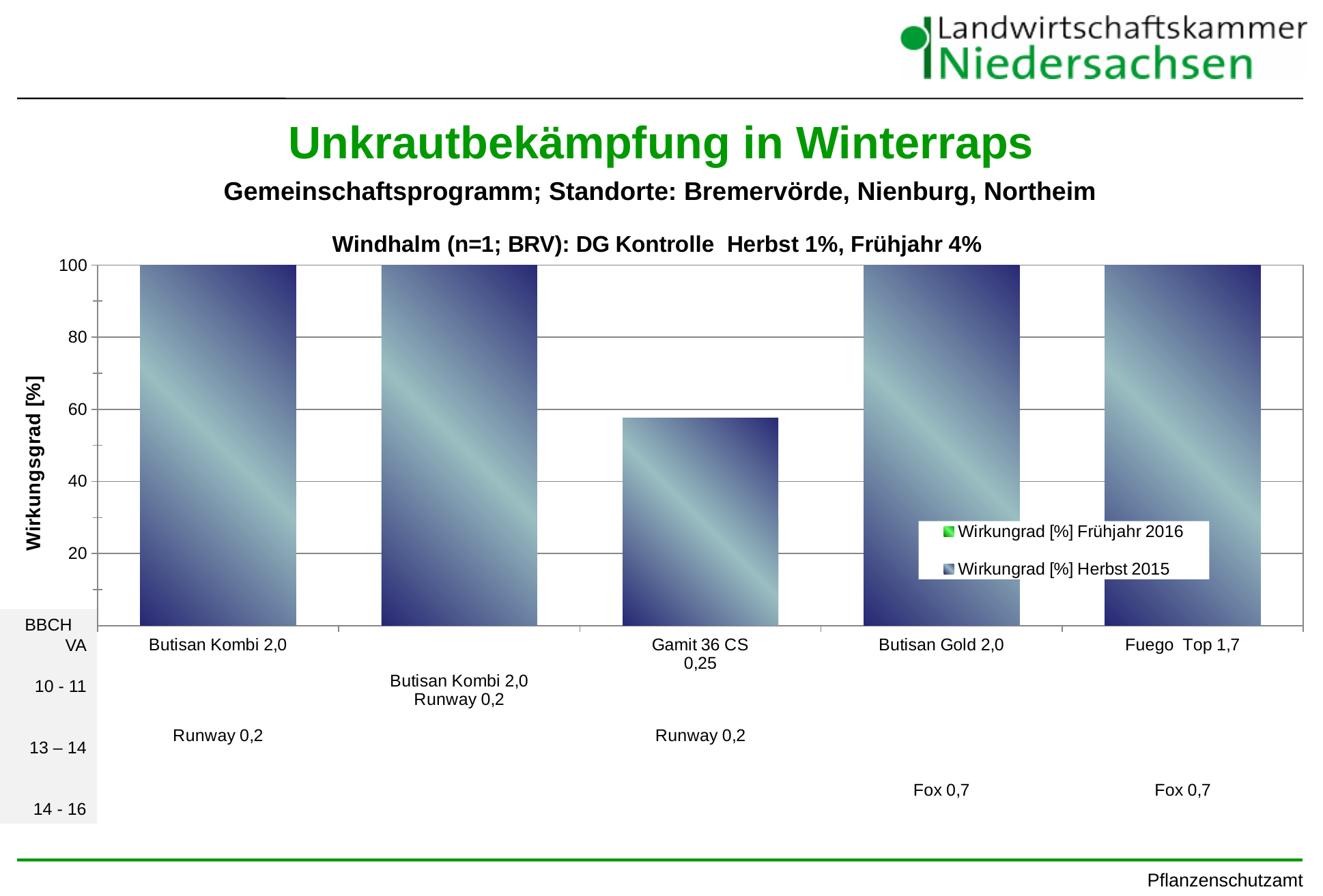
How many series does the chart legend list? 2 Is the Wirkungsgrad for Gamit 36 CS 0,25 greater or less than 40? greater What is the label of the vertical axis of the chart? Wirkungsgrad [%] What is the Wirkungsgrad [%] for Butisan Kombi 2,0 (first bar)? 100 Which has a higher Wirkungsgrad, Gamit 36 CS 0,25 or Butisan Gold 2,0? Butisan Gold 2,0 What is the Wirkungsgrad [%] for Butisan Gold 2,0? 100 What is the Wirkungsgrad [%] for Fuego Top 1,7? 100 What type of chart is shown on the slide? bar chart How many bars (treatment categories) are plotted in the chart? 5 What is the title of the chart? Windhalm (n=1; BRV): DG Kontrolle Herbst 1%, Frühjahr 4% Is the Wirkungsgrad for Gamit 36 CS 0,25 greater or less than 80? less Which treatment has the lowest Wirkungsgrad in the chart? Gamit 36 CS 0,25